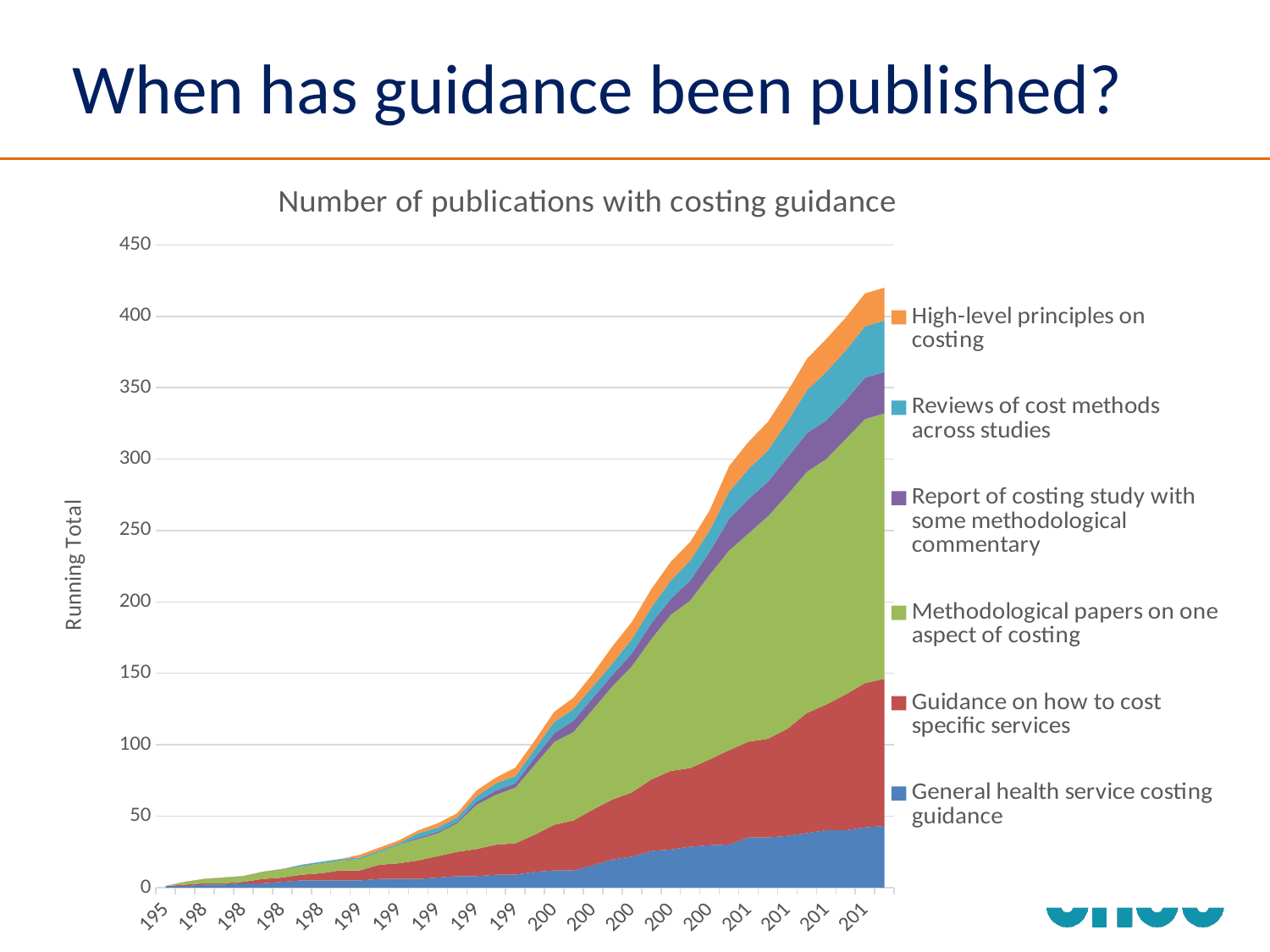
At the right-hand end of the chart, is the value for General health service costing guidance greater or less than 100? less Does the running total of publications rise or fall over time along the x axis? Rise At the right-hand end of the chart, is the cumulative top of the Methodological papers on one aspect of costing band greater or less than 300? greater Is the total running number of publications at the right-hand end of the chart greater or less than 450? less What is the title of the chart? Number of publications with costing guidance How many series does the legend list? 6 What kind of chart is shown on the slide? Stacked area chart At the right-hand end of the chart, which is larger: the Methodological papers on one aspect of costing band or the General health service costing guidance band? Methodological papers on one aspect of costing Which series accounts for the largest share of the running total at the right-hand end of the chart? Methodological papers on one aspect of costing What is the label on the vertical axis? Running Total